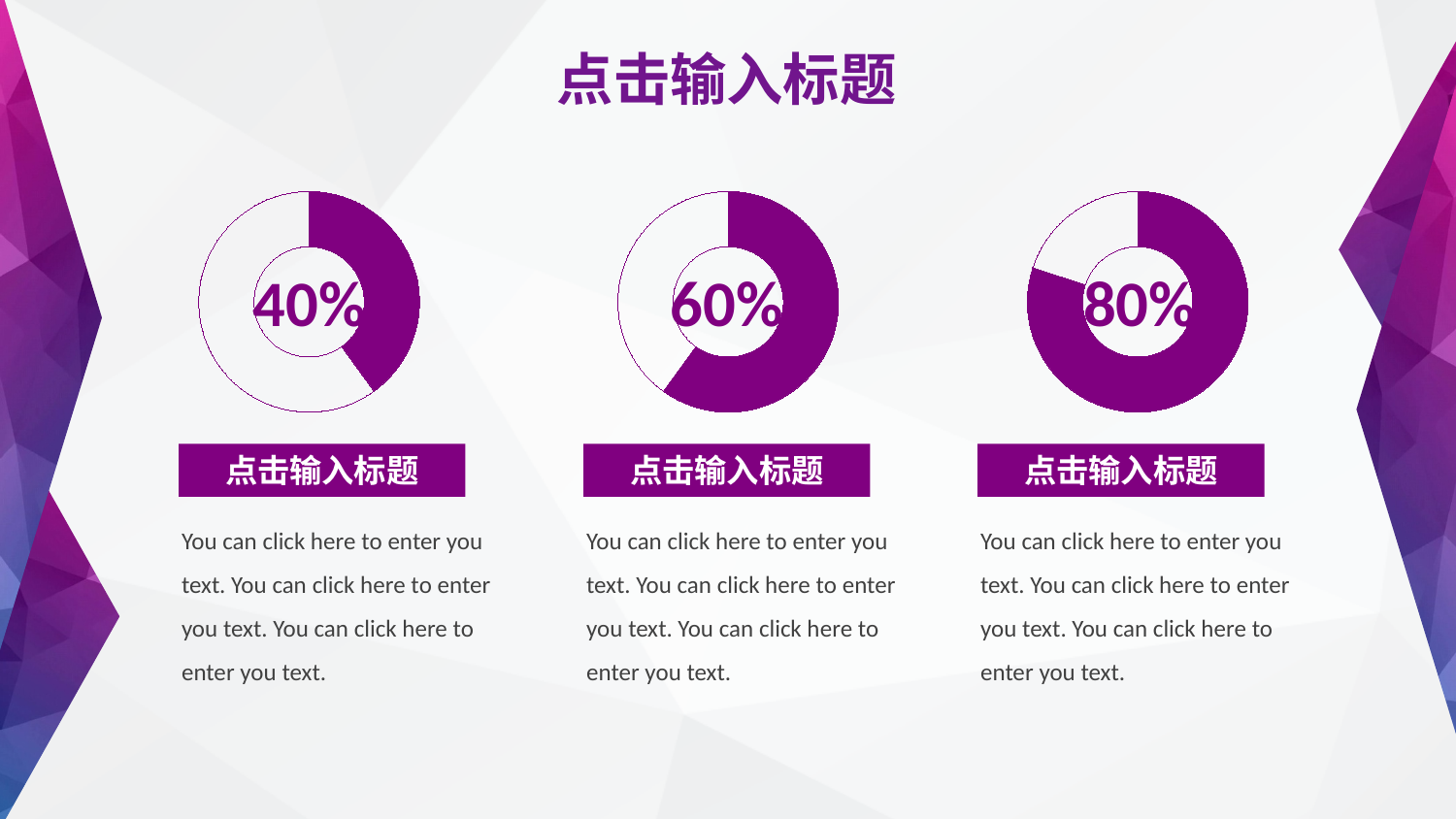
What percentage is shown in the right donut chart? 80% Which of the three donut charts shows the highest percentage? The right chart (80%) What is the difference between the percentage in the middle donut chart and the percentage in the left donut chart? 20% What percentage is shown in the left donut chart? 40% What kind of chart is used to display the percentages on the slide? Donut chart Do the percentages increase or decrease from the left chart to the right chart? Increase What percentage is shown in the middle donut chart? 60% Which is larger, the percentage in the middle donut chart or the percentage in the left donut chart? The middle chart (60%) What is the difference between the percentage in the right donut chart and the percentage in the left donut chart? 40% Which of the three donut charts shows the lowest percentage? The left chart (40%) What colour is the filled portion of each donut chart? Purple How many donut charts are on the slide? 3